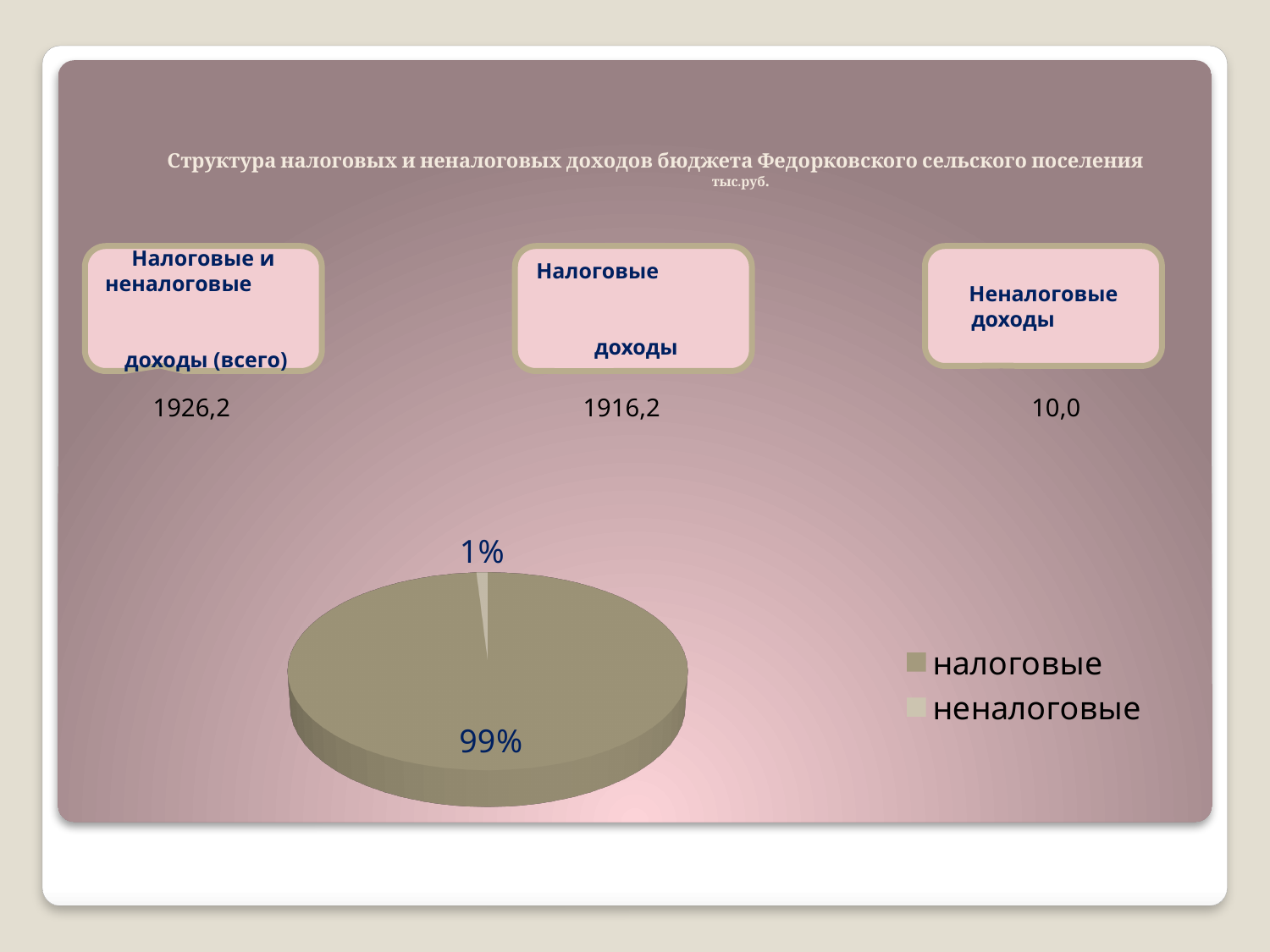
How many slices does the pie chart have? 2 Which slice of the pie chart is the smallest? неналоговые Which is larger in the pie chart, the "налоговые" slice or the "неналоговые" slice? налоговые What kind of chart is shown on the slide? pie chart Which slice of the pie chart is the largest? налоговые What are the two legend entries of the pie chart? налоговые, неналоговые What is the difference in percentage points between the "налоговые" and "неналоговые" slices of the pie chart? 98 How many entries does the pie chart's legend list? 2 Is the share of the "налоговые" slice greater or less than 50%? greater What share of the pie chart does the "налоговые" slice represent? 99% What share of the pie chart does the "неналоговые" slice represent? 1%